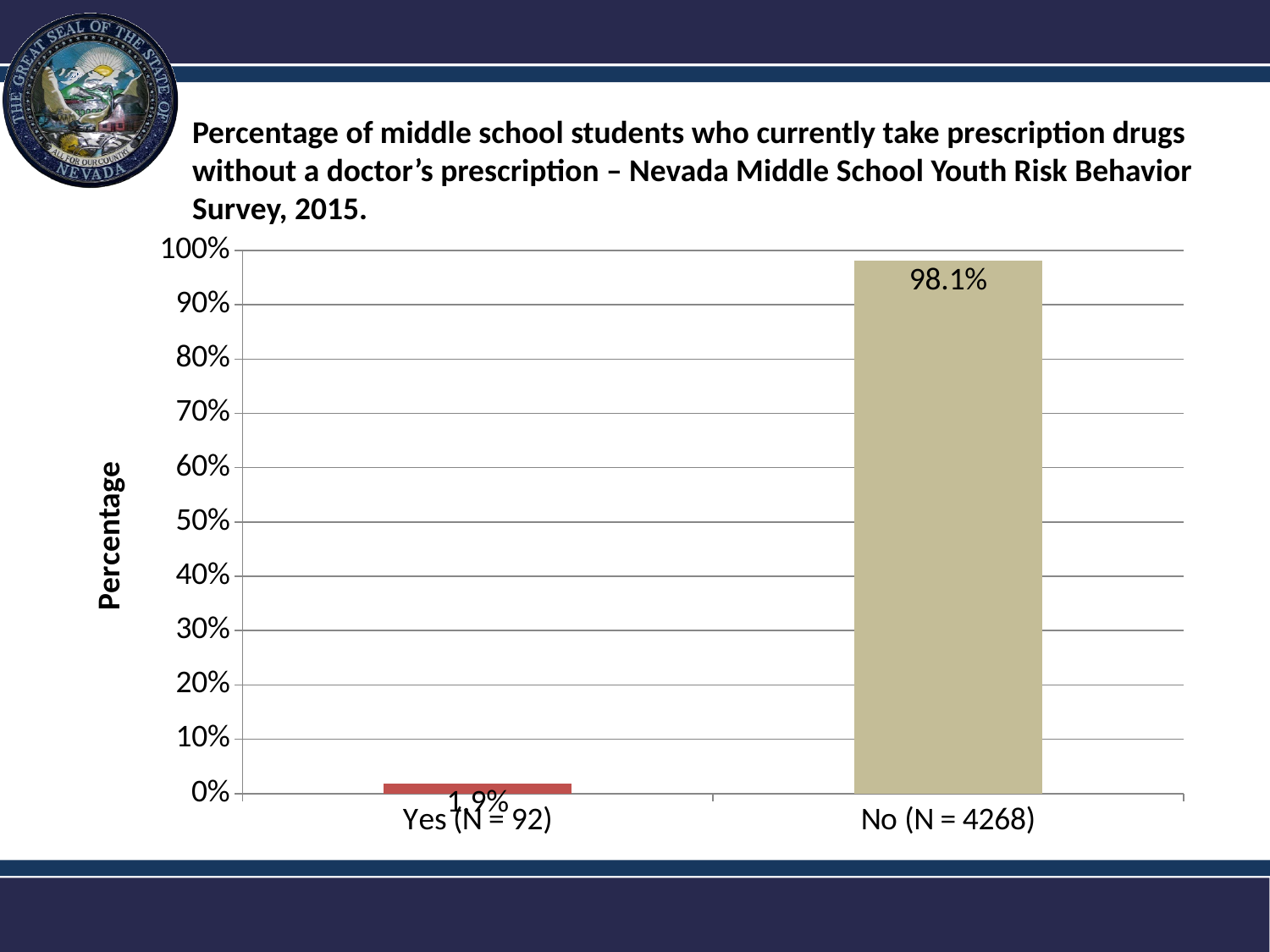
What is the difference in percentage points between the "No" and "Yes" categories? 96.2% Is the value for "No (N = 4268)" greater or less than 90%? greater What kind of chart is shown on the slide? Bar chart What percentage of middle school students answered "Yes" to currently taking prescription drugs without a doctor's prescription? 1.9% How many students are in the "No" group according to the category label? 4268 How many categories are shown on the chart? 2 Which category has the highest percentage? No (N = 4268) What percentage of middle school students answered "No" to currently taking prescription drugs without a doctor's prescription? 98.1% Which is larger, the percentage for "Yes" or the percentage for "No"? No What is the label of the vertical axis? Percentage Is the value for "Yes (N = 92)" greater or less than 10%? less Which category has the lowest percentage? Yes (N = 92)